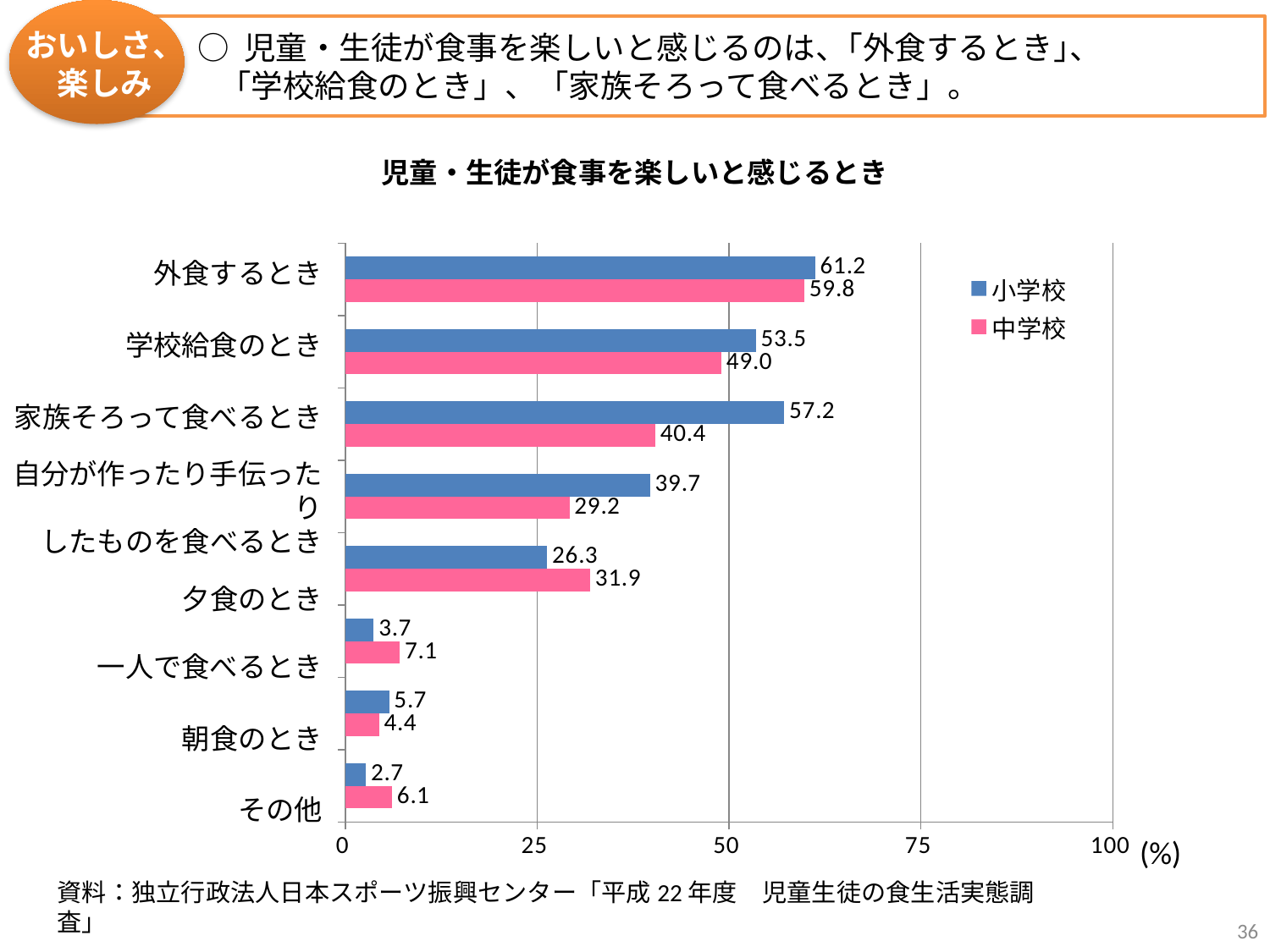
Which category has the highest value for 中学校? 外食するとき Is the value for 小学校 in the 学校給食のとき category greater or less than 50? greater What is the value for 中学校 in the 夕食のとき category? 31.9 Which category has the lowest value for 小学校? その他 What is the value for 中学校 in the 家族そろって食べるとき category? 40.4 How many categories are plotted in the chart? 8 What is the difference between the 小学校 and 中学校 values for 家族そろって食べるとき? 16.8 What is the value for 小学校 in the 外食するとき category? 61.2 In the 夕食のとき category, which series has the larger value, 小学校 or 中学校? 中学校 What kind of chart is shown on the slide? bar chart What is the title of the chart? 児童・生徒が食事を楽しいと感じるとき How many series does the legend list? 2